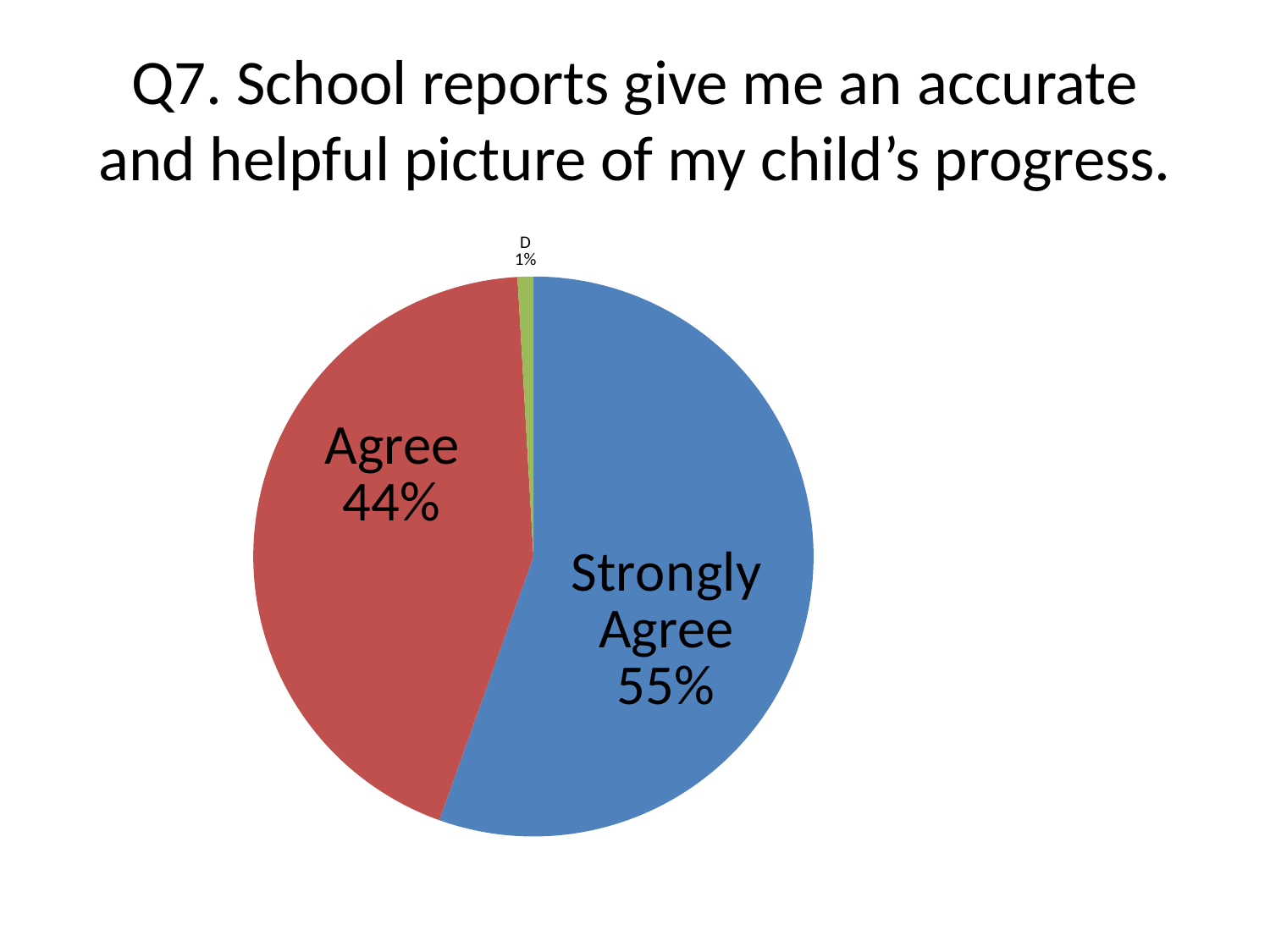
What percentage is shown for the slice labelled D? 1% What is the combined share of Strongly Agree and Agree? 99% What colour is the Strongly Agree slice? Blue Which is larger, the share for Agree or the share for Strongly Agree? Strongly Agree What percentage of respondents answered Strongly Agree? 55% What is the title of the slide? Q7. School reports give me an accurate and helpful picture of my child's progress. Which response has the largest share of the pie? Strongly Agree What percentage of respondents answered Agree? 44% Which response has the smallest share of the pie? D How many slices does the pie chart have? 3 What is the difference in percentage points between Strongly Agree and Agree? 11 What kind of chart is shown on the slide? Pie chart